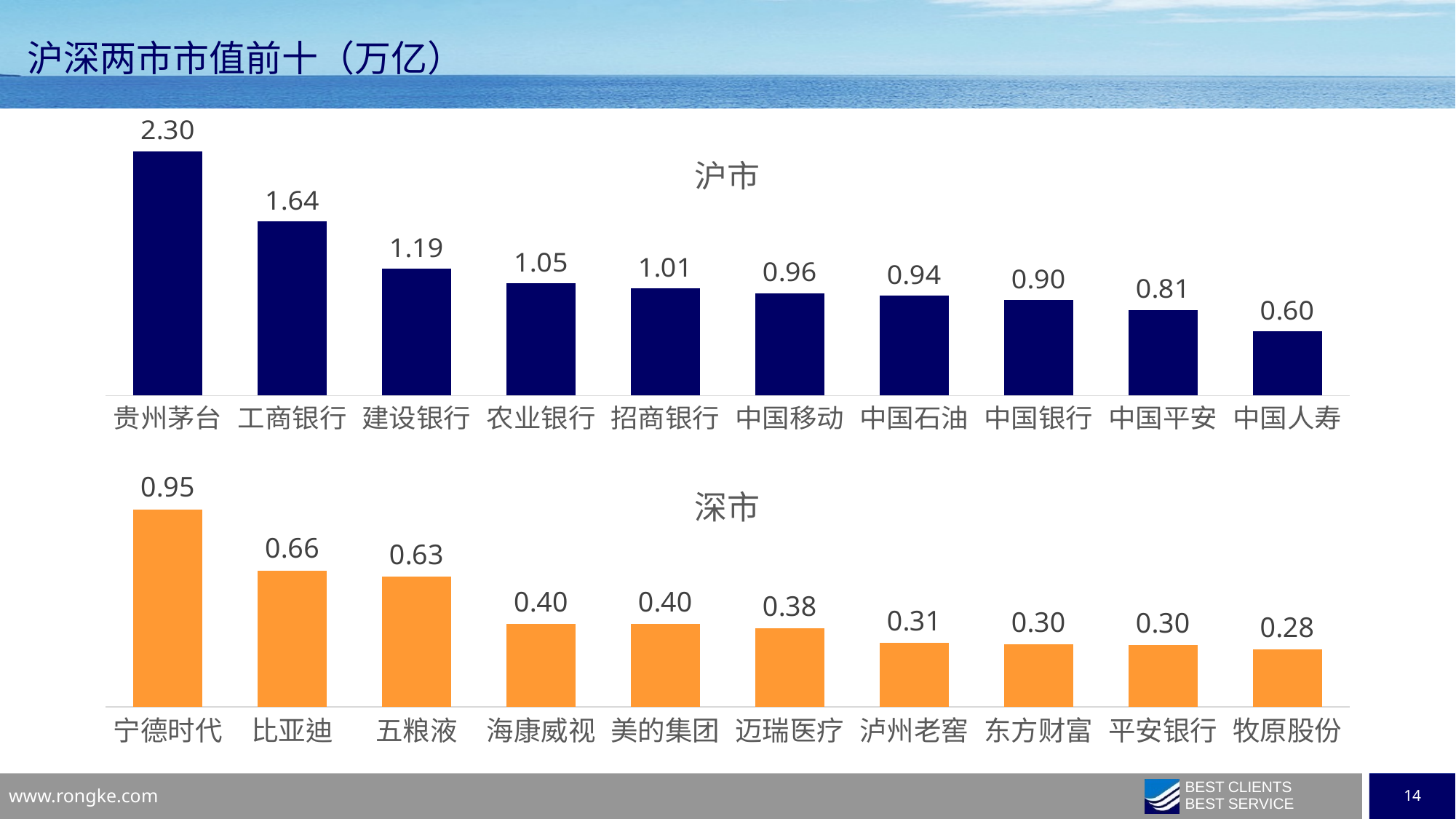
In the 深市 chart, what is the difference between 宁德时代 and 五粮液? 0.32 In the 沪市 chart, which company has the highest value? 贵州茅台 In the 沪市 chart, which is larger, 建设银行 or 中国平安? 建设银行 In the 沪市 chart, what is the value for 中国移动? 0.96 What kind of chart is the 沪市 chart? Bar chart In the 深市 chart, what is the value for 比亚迪? 0.66 Do the values in the 深市 chart rise or fall from left to right? Fall In the 深市 chart, which company has the lowest value? 牧原股份 In the 沪市 chart, what is the difference between 贵州茅台 and 工商银行? 0.66 In the 沪市 chart, what is the value for 贵州茅台? 2.30 How many companies are shown in the 深市 chart? 10 In the 深市 chart, what is the value for 迈瑞医疗? 0.38